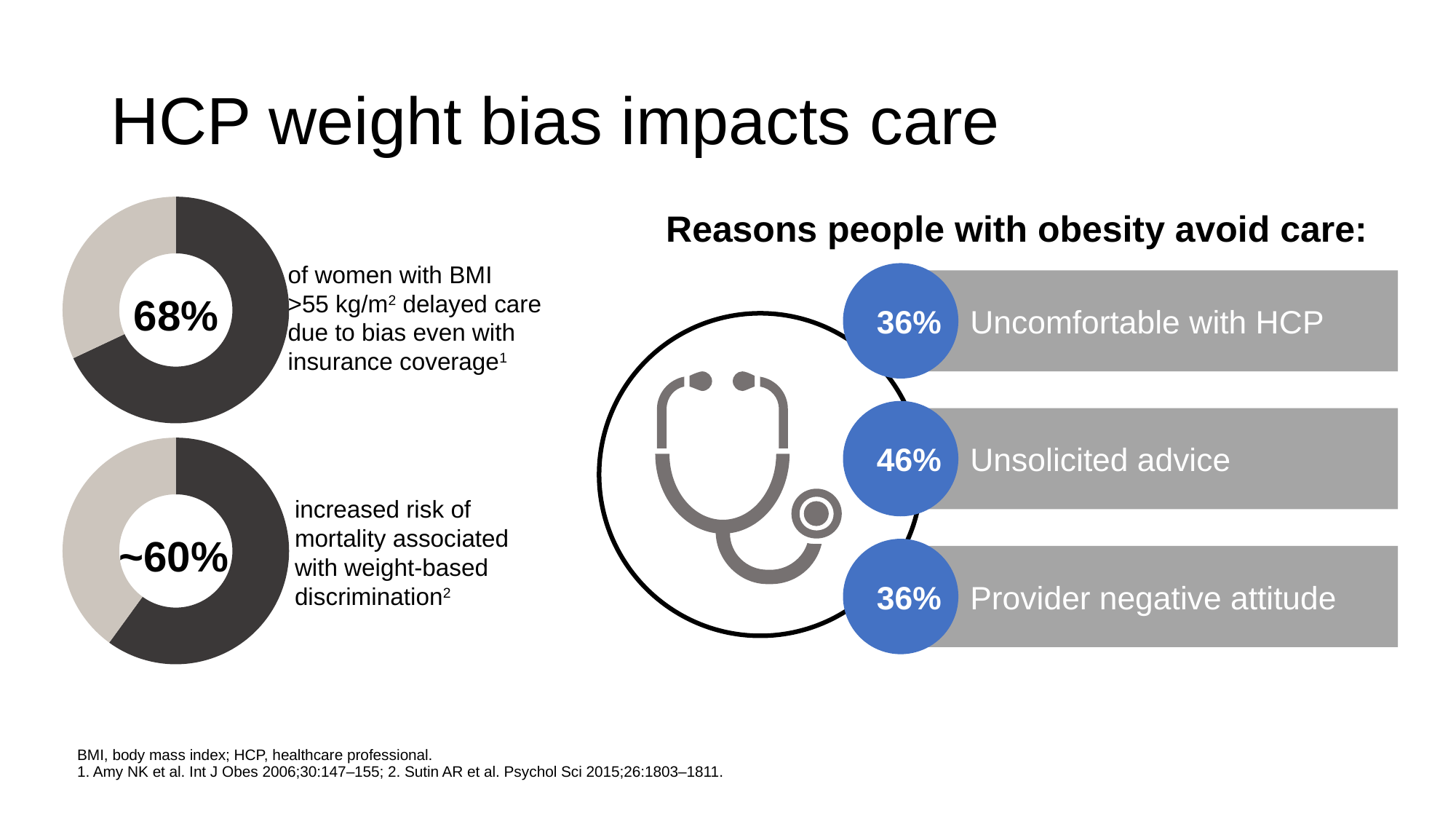
What value is shown in the centre of the top donut chart on the left? 68% In the 'Reasons people with obesity avoid care' list, what is the difference in percentage points between 'Unsolicited advice' and 'Provider negative attitude'? 10 percentage points In the top donut chart, is the value shown greater or less than 50%? greater What value is shown in the centre of the bottom donut chart on the left? ~60% In the 'Reasons people with obesity avoid care' list, what percentage is given for 'Uncomfortable with HCP'? 36% What kind of chart is used on the left side of the slide to show the 68% and ~60% figures? Donut chart In the 'Reasons people with obesity avoid care' list, what percentage is given for 'Unsolicited advice'? 46% How many donut charts are on the slide? 2 What share of the top donut chart is filled by the dark segment? 68% In the 'Reasons people with obesity avoid care' list, which reason has the highest percentage? Unsolicited advice How many reasons are listed under 'Reasons people with obesity avoid care'? 3 Which donut chart shows the larger value, the top one or the bottom one? The top one (68%)